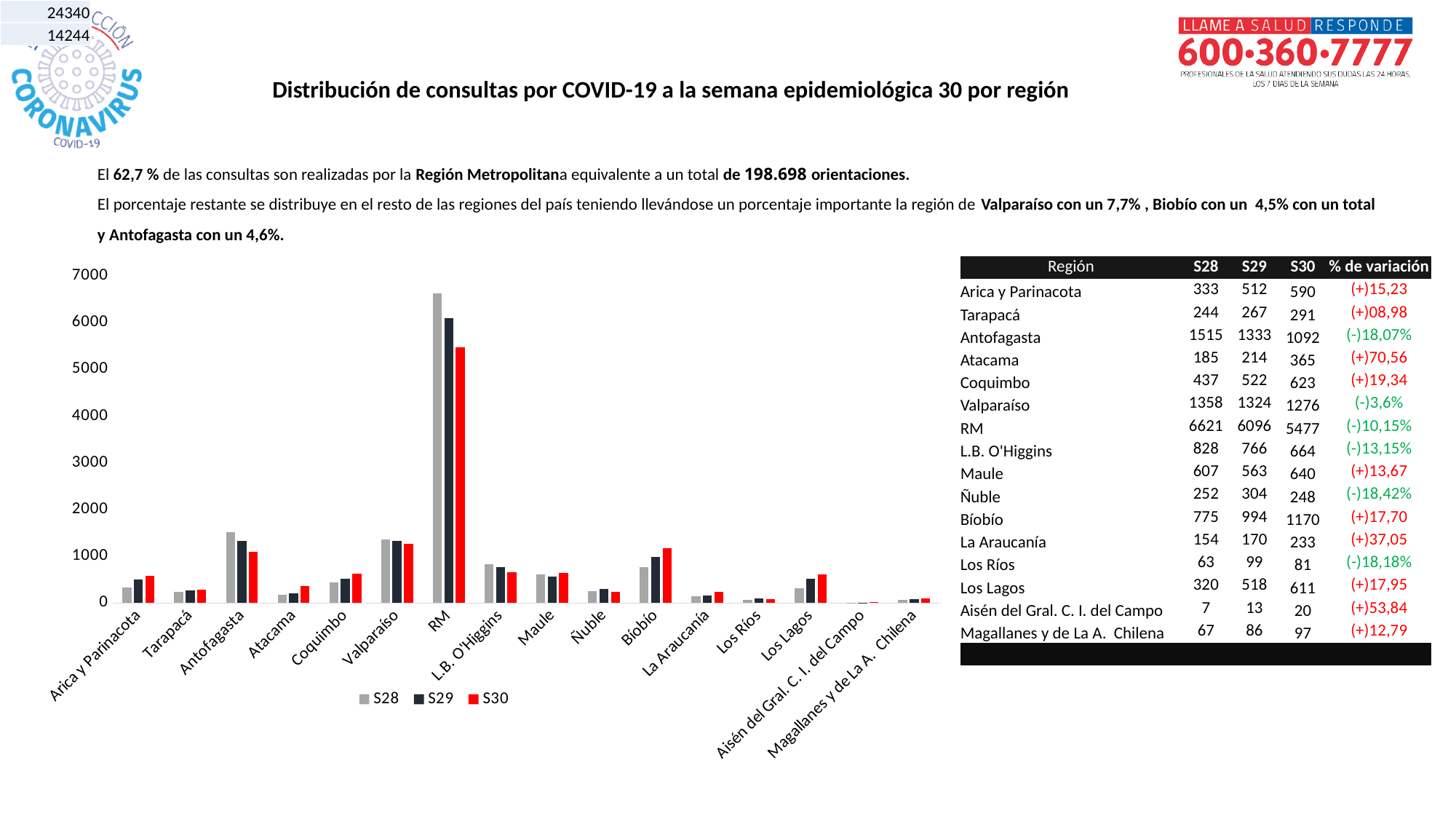
Is the S28 value for Antofagasta greater or less than 1000? greater What are the entries in the chart legend? S28, S29, S30 How many regions are shown along the x axis of the chart? 16 What kind of chart is shown on the slide? bar chart How many series does the chart legend list? 3 Which is larger, the S28 value for Antofagasta or the S28 value for Valparaíso? Antofagasta What is the S29 value for Valparaíso? 1324 Is the S28 value for RM greater or less than 6000? greater What is the difference between the S28 and S30 values for RM? 1144 What is the S30 value for Biobío? 1170 Which region has the highest S28 value in the chart? RM Do the values for RM rise or fall from S28 to S30? fall